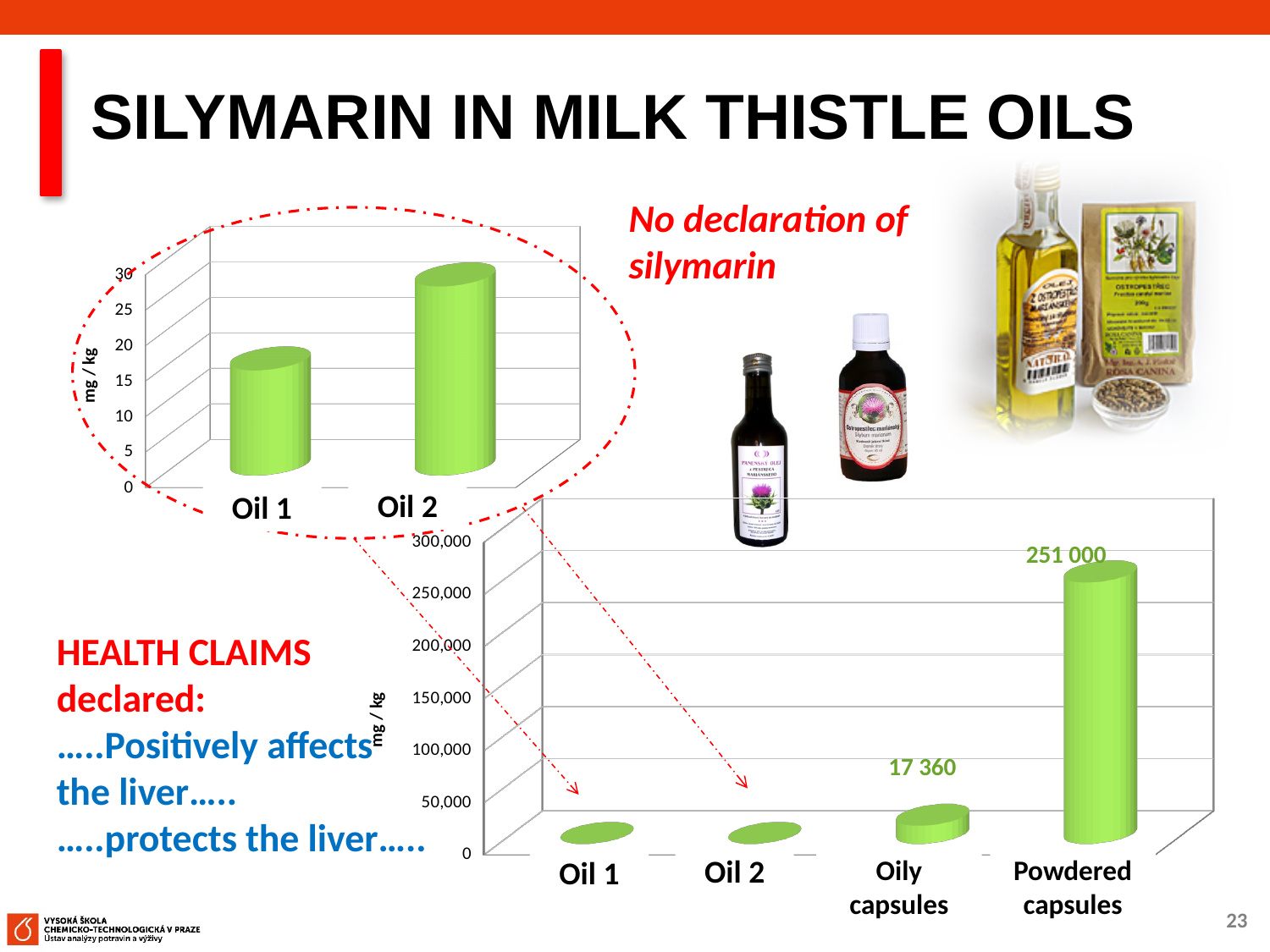
What kind of chart is the bottom chart? bar chart How many categories are shown in the top-left chart? 2 In the top-left chart, is the value for Oil 1 greater or less than 20? less In the bottom chart, what is the difference between the values for Powdered capsules and Oily capsules? 233 640 In the bottom chart, what is the value for Powdered capsules? 251 000 In the top-left chart, is the value for Oil 2 greater or less than 25? greater In the bottom chart, is the value for Oil 1 greater or less than 50,000? less In the bottom chart, what is the value for Oily capsules? 17 360 In the bottom chart, which is larger, the value for Oily capsules or the value for Oil 2? Oily capsules How many categories are shown in the bottom chart? 4 In the top-left chart, which category has the higher value? Oil 2 In the bottom chart, which category has the highest value? Powdered capsules